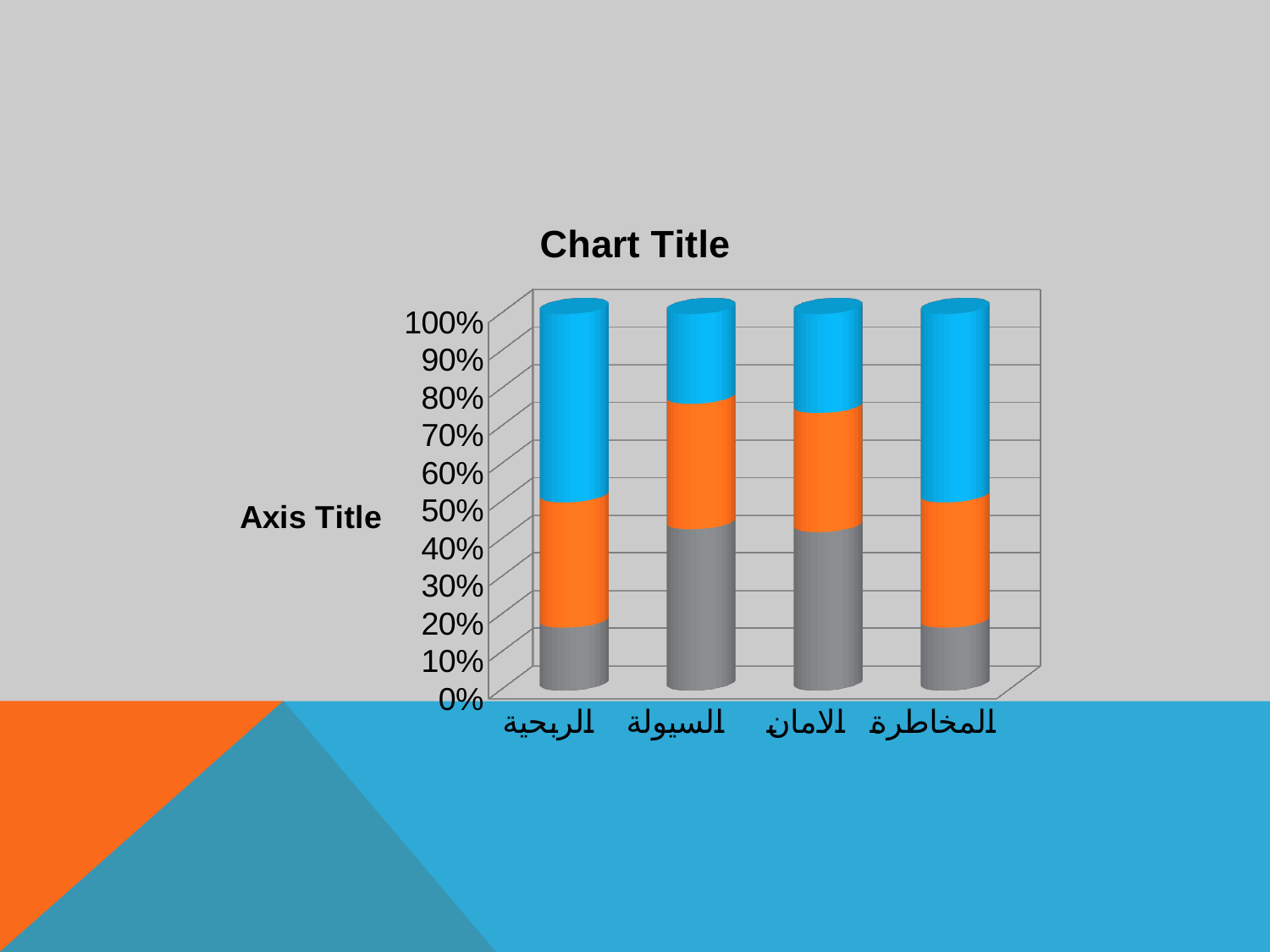
Is the grey (bottom) segment for السيولة greater or less than 30%? greater Is the grey (bottom) segment for المخاطرة greater or less than 30%? less What kind of chart is shown on the slide? bar chart Is the top of the orange (middle) segment for السيولة above or below the 70% line? above How many categories are shown on the x axis of the chart? 4 Which has the larger grey (bottom) segment, الربحية or السيولة? السيولة What is the total height of the stacked bar for الربحية? 100% Which has the larger blue (top) segment, الامان or المخاطرة? المخاطرة How many coloured segments does each stacked bar contain? 3 What is the title of the chart? Chart Title